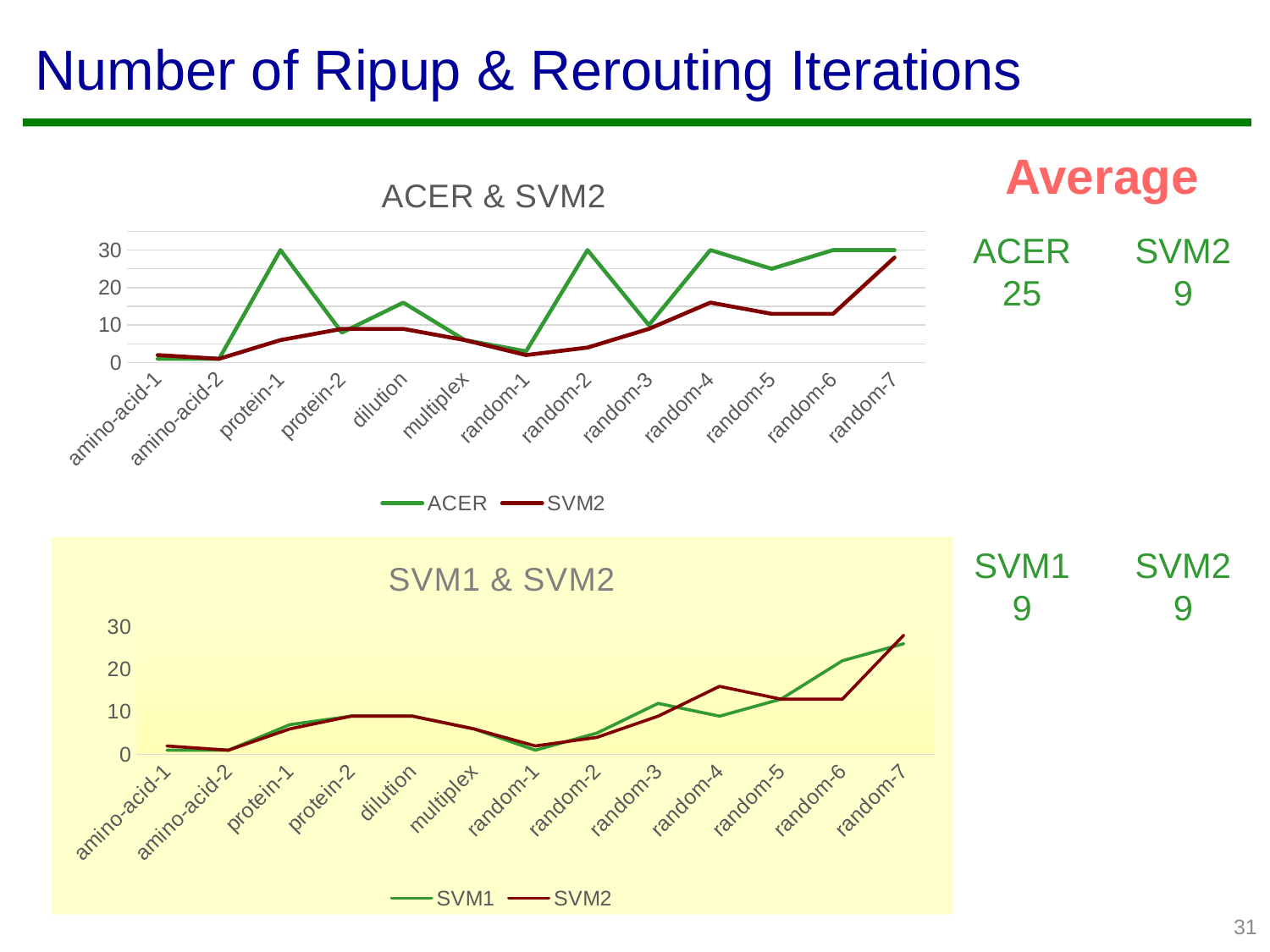
In the "ACER & SVM2" chart, is the SVM2 value for random-1 greater or less than 10? less In the "SVM1 & SVM2" chart, does the SVM1 line rise or fall from random-4 to random-7? rise What are the two legend entries of the "ACER & SVM2" chart? ACER and SVM2 In the "ACER & SVM2" chart, which series has the larger value at random-2, ACER or SVM2? ACER How many series does the legend of the "ACER & SVM2" chart list? 2 In the "ACER & SVM2" chart, is the ACER value for protein-1 greater or less than 20? greater What is the title of the lower chart on the slide? SVM1 & SVM2 In the "SVM1 & SVM2" chart, is the SVM1 value for random-6 greater or less than 20? greater How many categories are plotted along the x axis of the "SVM1 & SVM2" chart? 13 In the "SVM1 & SVM2" chart, which series has the larger value at random-4, SVM1 or SVM2? SVM2 What kind of chart is the "ACER & SVM2" chart? line chart